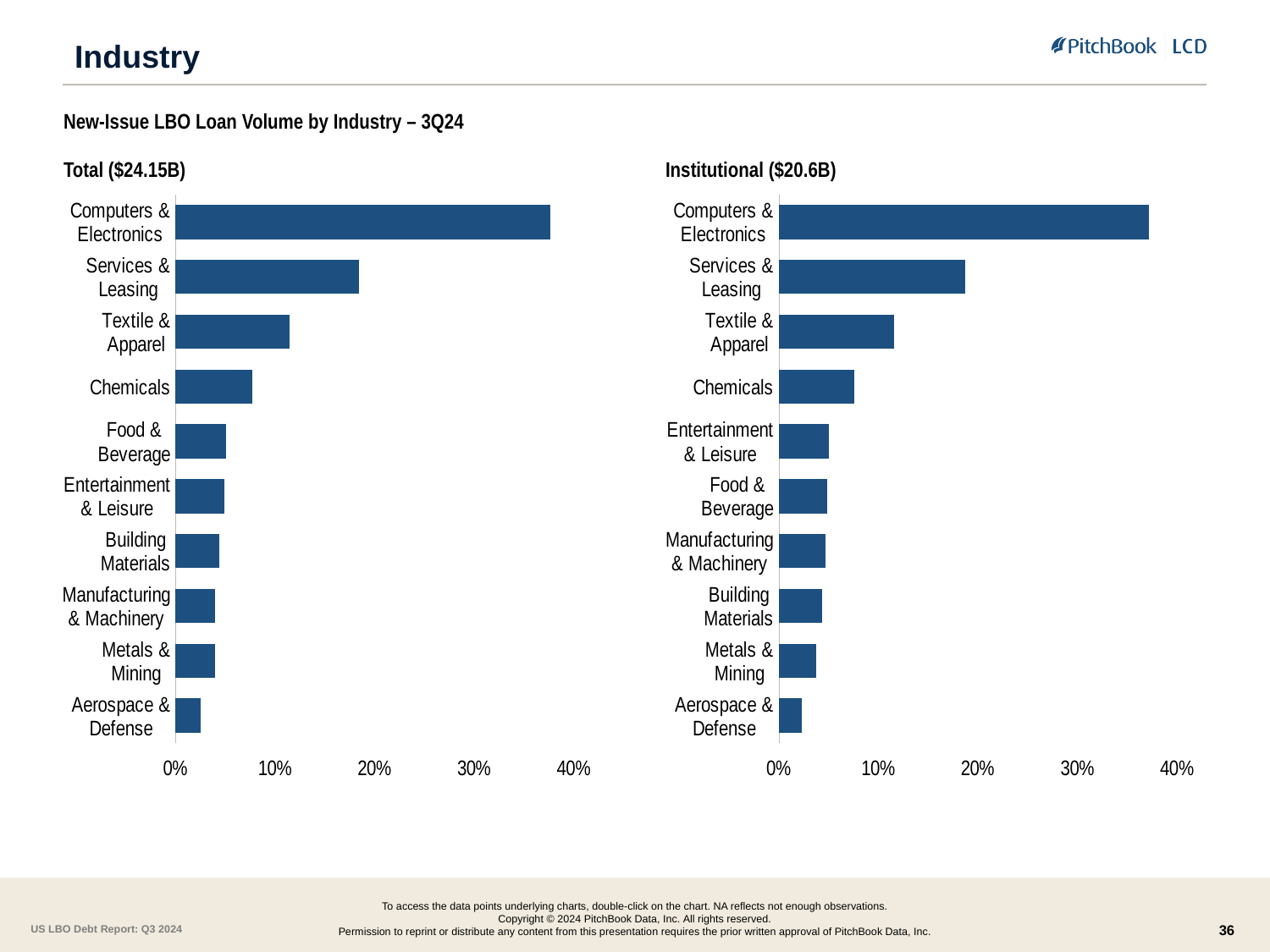
In the Institutional ($20.6B) chart, which is larger, Textile & Apparel or Aerospace & Defense? Textile & Apparel In the Total ($24.15B) chart, which industry has the lowest share? Aerospace & Defense In the Total ($24.15B) chart, how many industries are shown? 10 What is the title of the chart on the right side of the slide? Institutional ($20.6B) What is the overall title given above the two charts? New-Issue LBO Loan Volume by Industry – 3Q24 In the Institutional ($20.6B) chart, which industry has the highest share? Computers & Electronics In the Total ($24.15B) chart, what kind of chart is used? Bar chart In the Institutional ($20.6B) chart, is the value for Services & Leasing greater or less than 20%? less In the Total ($24.15B) chart, which is larger, Services & Leasing or Chemicals? Services & Leasing In the Total ($24.15B) chart, is the value for Computers & Electronics greater or less than 30%? greater In the Total ($24.15B) chart, is the value for Textile & Apparel greater or less than 10%? greater